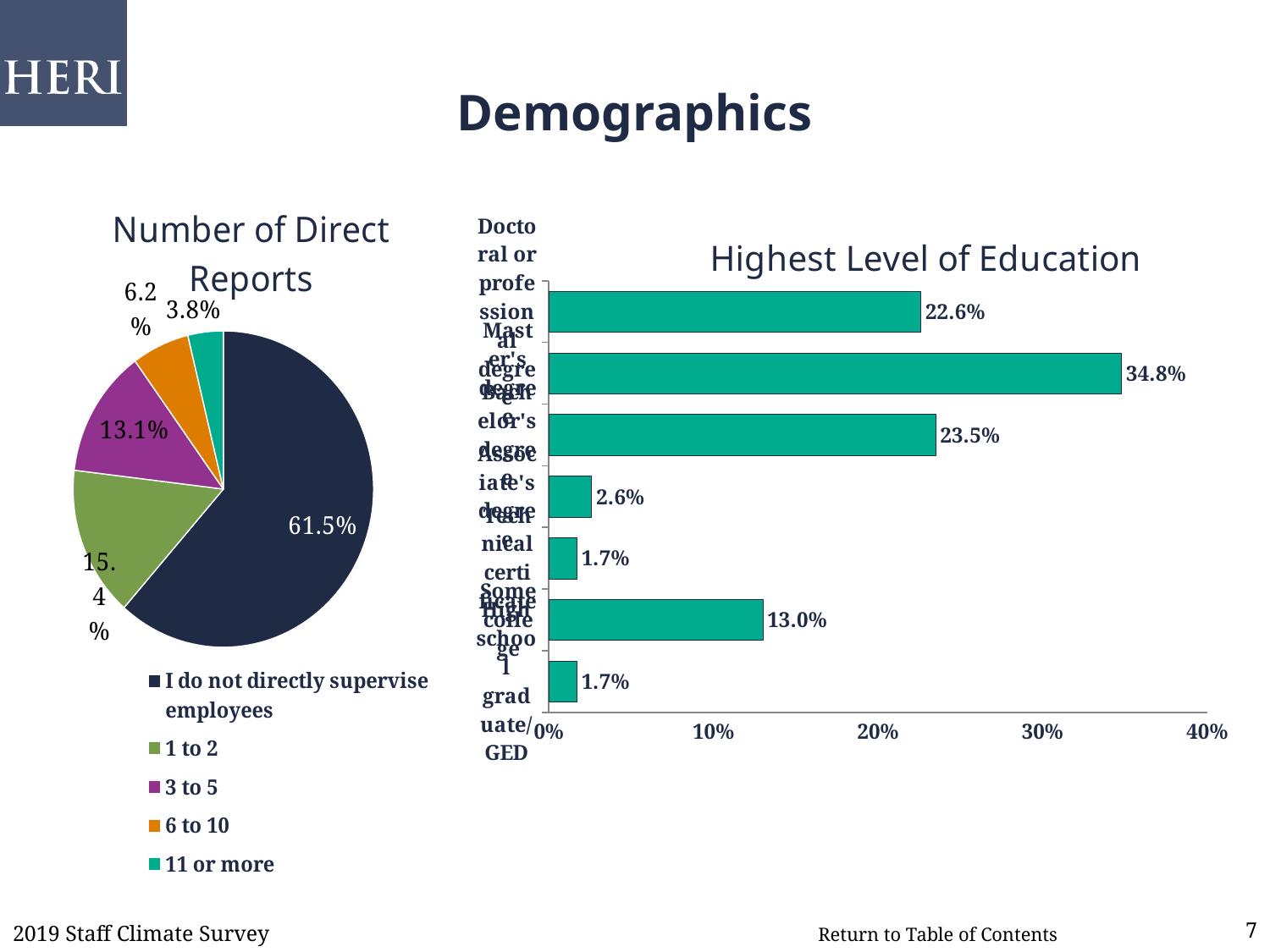
In the Highest Level of Education chart, is the value of the sixth bar from the top (13.0%) greater or less than 10%? greater In the Number of Direct Reports pie chart, what percentage of respondents do not directly supervise employees? 61.5% In the Number of Direct Reports pie chart, how many categories does the legend list? 5 In the Highest Level of Education chart, is the second bar from the top larger or smaller than the third bar from the top? Larger In the Number of Direct Reports pie chart, what is the share for the '1 to 2' category? 15.4% In the Number of Direct Reports pie chart, what is the difference between the '3 to 5' share and the '6 to 10' share? 6.9% What kind of chart is the Highest Level of Education chart? Bar chart In the Highest Level of Education chart, what is the value of the top bar (Doctoral or professional degree)? 22.6% In the Highest Level of Education chart, what is the highest value shown? 34.8% In the Number of Direct Reports pie chart, which category has the smallest slice? 11 or more In the Highest Level of Education chart, what is the value of the third bar from the top? 23.5% In the Highest Level of Education chart, how many bars are plotted? 7